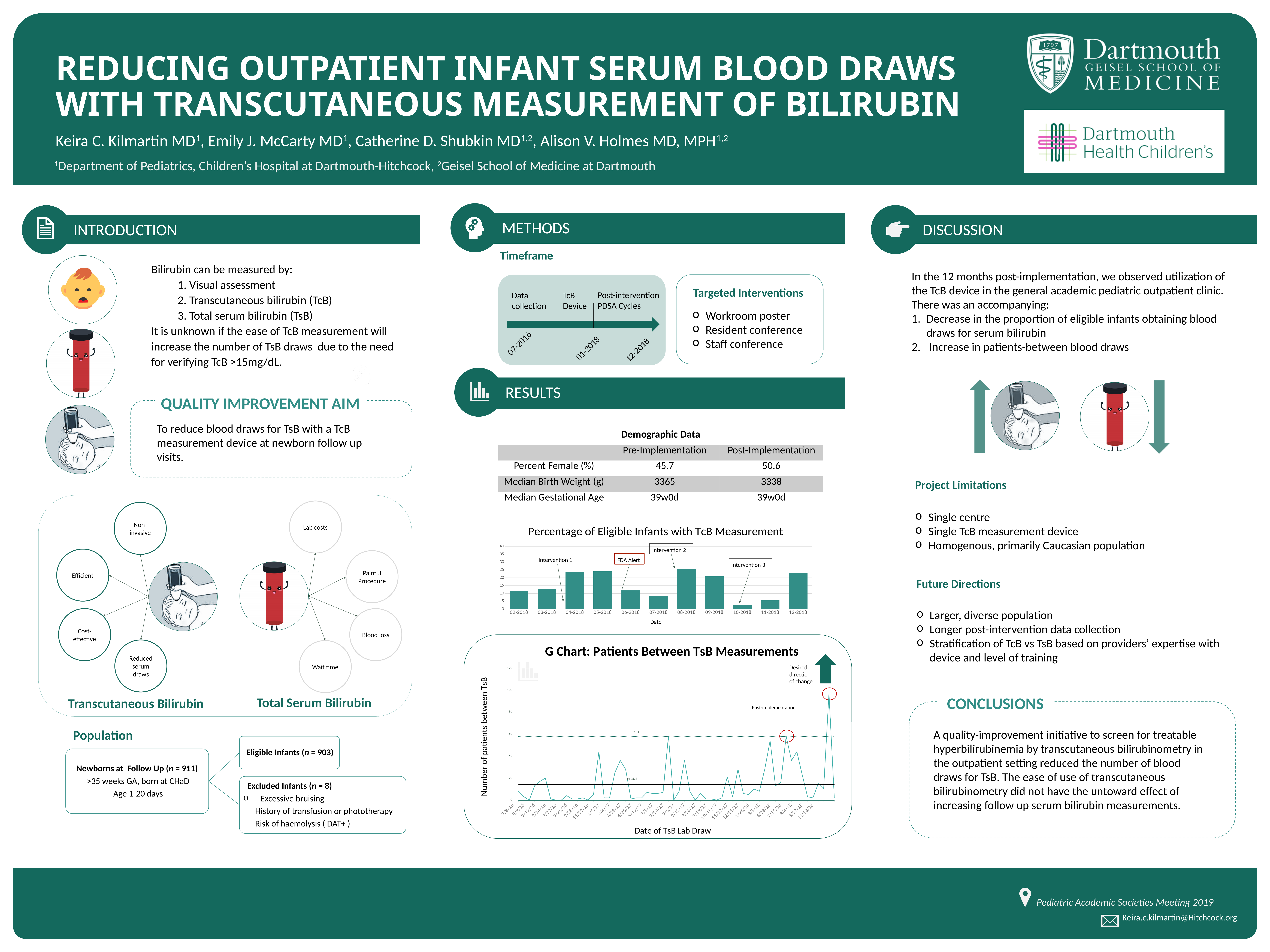
In the 'Percentage of Eligible Infants with TcB Measurement' chart, which is larger, the value for 10-2018 or the value for 11-2018? 11-2018 In the 'Percentage of Eligible Infants with TcB Measurement' chart, which month has the lowest value? 10-2018 In the 'Percentage of Eligible Infants with TcB Measurement' chart, is the value for 04-2018 greater or less than 20? greater In the 'Percentage of Eligible Infants with TcB Measurement' chart, how many months (bars) are shown on the x axis? 11 In the 'G Chart: Patients Between TsB Measurements', is the highest point on the line greater or less than 80? greater In the 'Percentage of Eligible Infants with TcB Measurement' chart, is the value for 10-2018 greater or less than 5? less What kind of chart is 'G Chart: Patients Between TsB Measurements'? line chart In the 'Percentage of Eligible Infants with TcB Measurement' chart, what is the label of the x axis? Date In the 'Percentage of Eligible Infants with TcB Measurement' chart, which is larger, the value for 04-2018 or the value for 07-2018? 04-2018 In the 'Percentage of Eligible Infants with TcB Measurement' chart, which annotation is shown in a red box? FDA Alert What kind of chart is 'Percentage of Eligible Infants with TcB Measurement'? bar chart